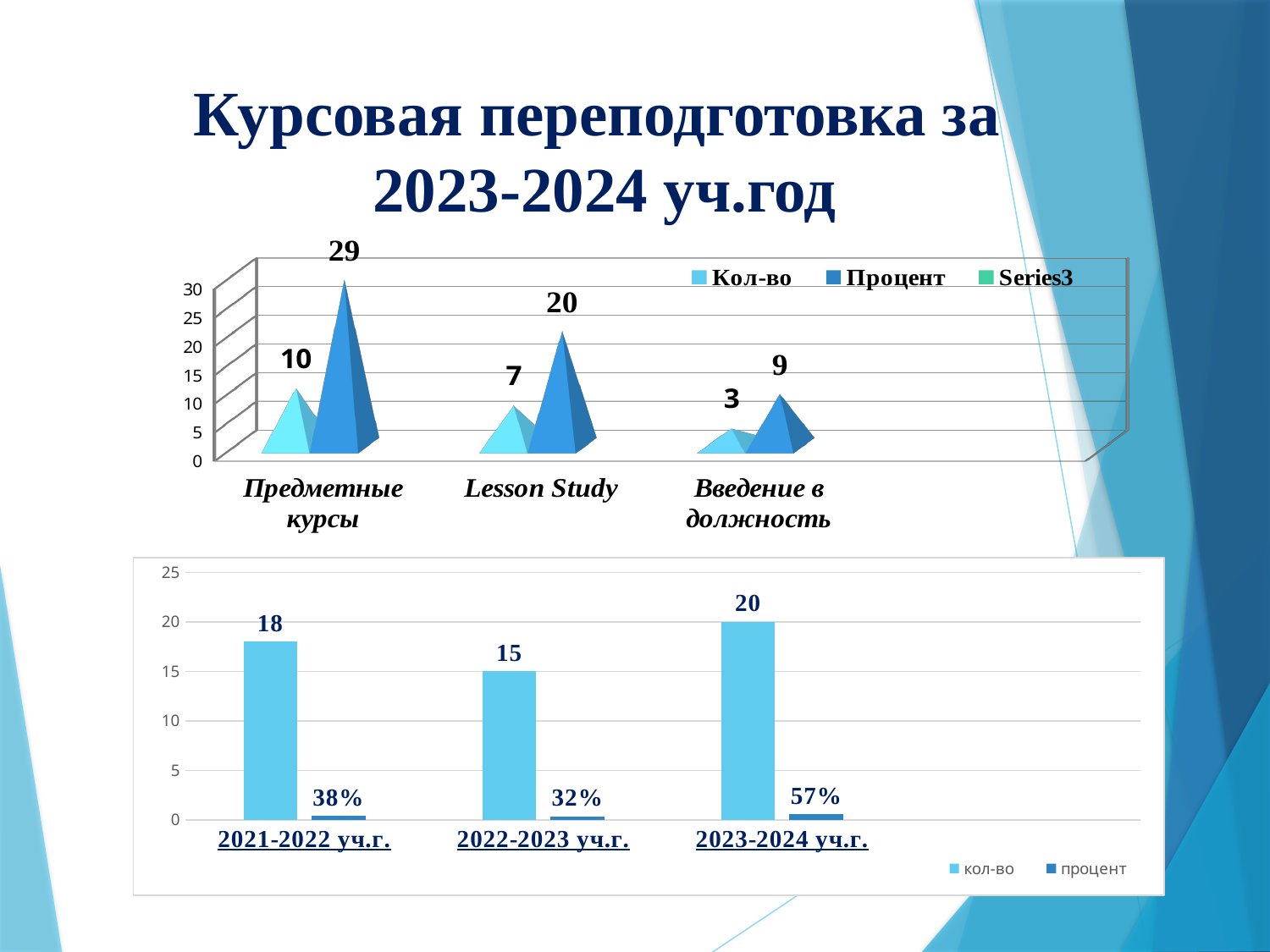
In the bottom chart, what is the кол-во value for 2022-2023 уч.г.? 15 In the top chart, what is the Процент value for Lesson Study? 20 In the bottom chart, what is the процент value for 2023-2024 уч.г.? 57% In the top chart, which category has the highest Процент value? Предметные курсы How many series does the legend of the top chart list? 3 In the top chart, what is the difference between the Процент values for Предметные курсы and Введение в должность? 20 In the top chart, which category has the lowest Кол-во value? Введение в должность In the top chart, what is the Кол-во value for Предметные курсы? 10 How many categories are shown on the x axis of the bottom chart? 3 In the bottom chart, is the кол-во value for 2021-2022 уч.г. larger or smaller than the value for 2022-2023 уч.г.? larger In the bottom chart, which year has the highest кол-во value? 2023-2024 уч.г. What kind of chart is the bottom chart? bar chart